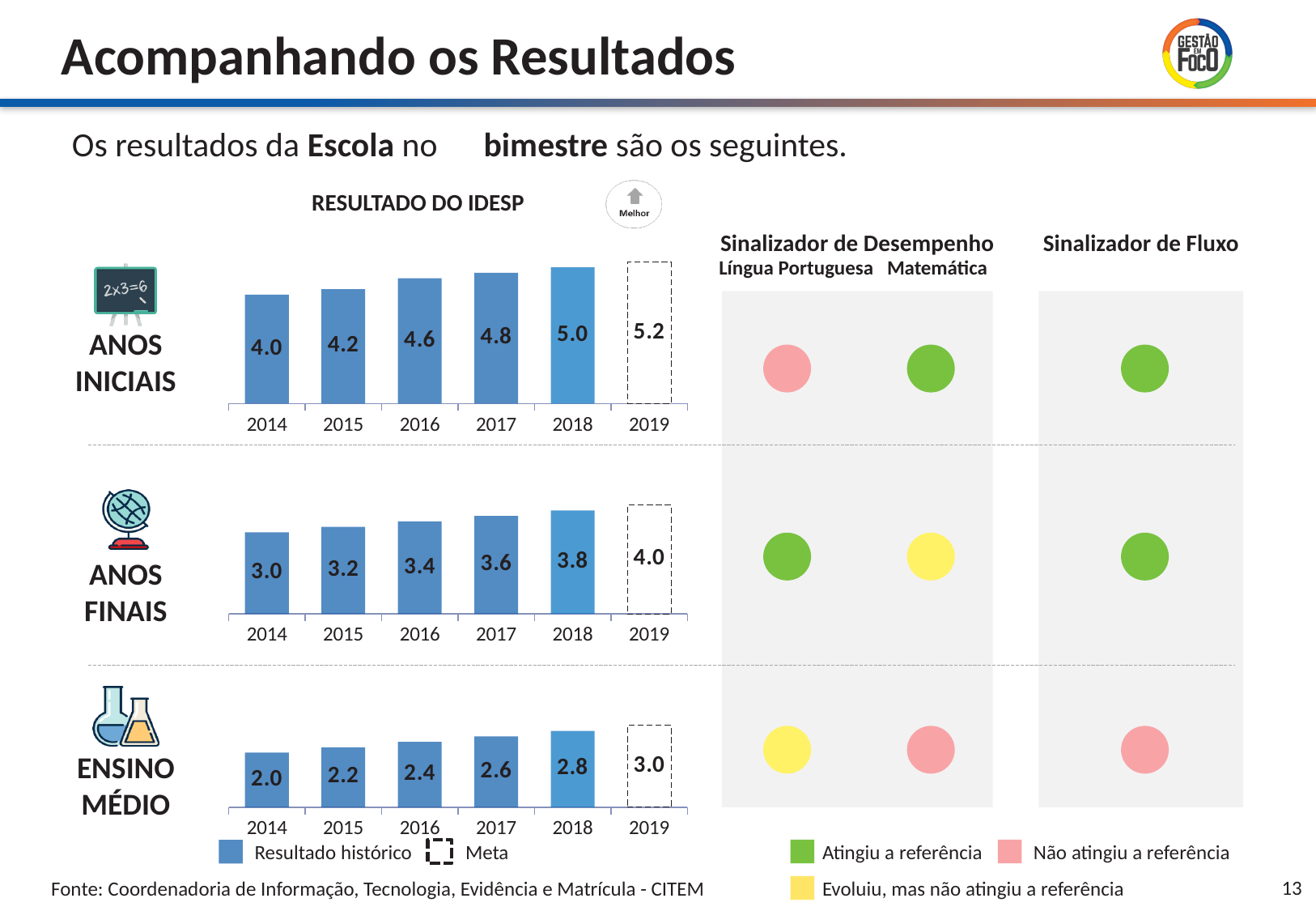
How many years are shown on the x axis of the ANOS FINAIS chart? 6 What type of chart is used to show the RESULTADO DO IDESP for ANOS INICIAIS? Bar chart In the ENSINO MÉDIO chart, which is larger, the value for 2015 or the value for 2017? 2017 In the ANOS FINAIS chart, do the values rise or fall from 2014 to 2018? Rise In the ANOS FINAIS chart, what is the difference between the 2019 Meta and the 2018 value? 0.2 In the ANOS FINAIS chart, what is the value for 2018? 3.8 In the ENSINO MÉDIO chart, which year has the highest value among the historical results (2014–2018)? 2018 In the ANOS INICIAIS chart, which year has the lowest value? 2014 In the ENSINO MÉDIO chart, what is the Meta (target) value shown for 2019? 3.0 In the ANOS INICIAIS chart, what is the difference between the 2018 value and the 2014 value? 1.0 What two entries does the legend below the IDESP charts list? Resultado histórico and Meta In the ANOS INICIAIS chart, what is the IDESP value for 2016? 4.6